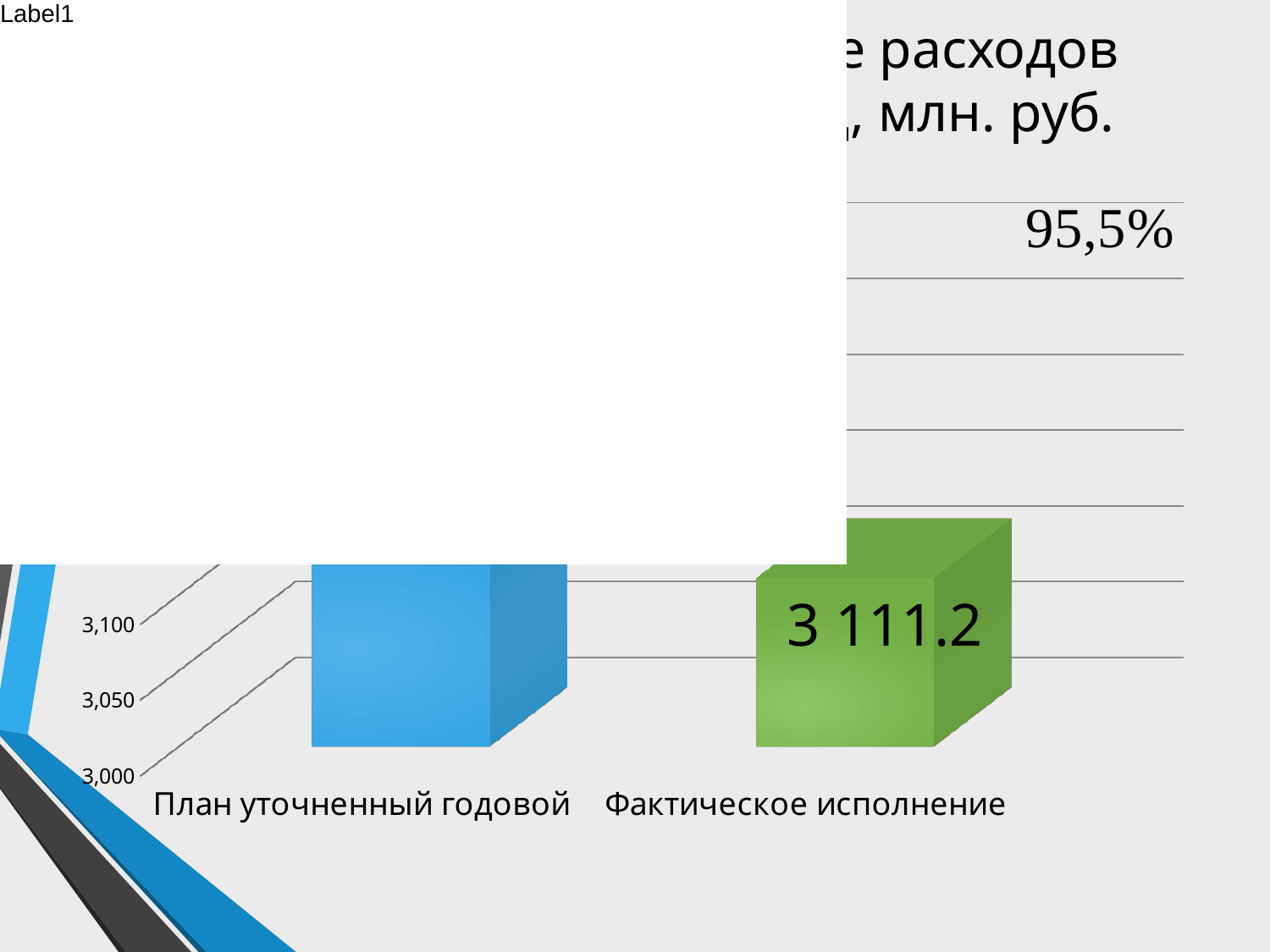
What is the value for Фактическое исполнение? 3 111.2 Do the values rise or fall from left to right along the x axis? fall Which category has the highest value? План уточненный годовой How many categories are shown on the x axis? 2 What kind of chart is shown on the slide? bar chart Which is larger, План уточненный годовой or Фактическое исполнение? План уточненный годовой What colour is the bar for План уточненный годовой? blue Is the value for Фактическое исполнение greater or less than 3,100? greater Is the value for План уточненный годовой greater or less than 3,050? greater Which category has the lowest value? Фактическое исполнение What colour is the bar for Фактическое исполнение? green